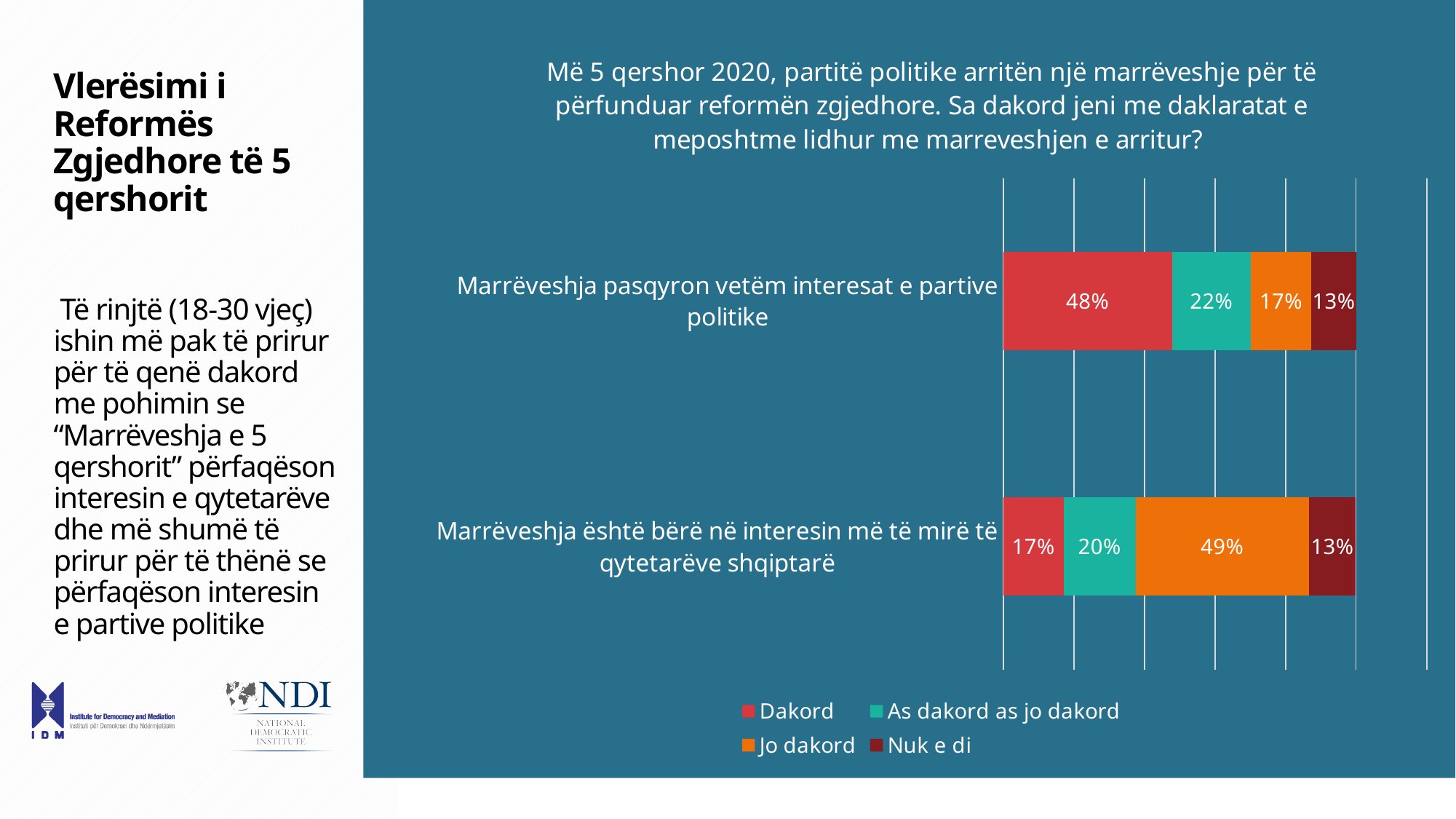
Which response category has the smallest share for the statement "Marrëveshja është bërë në interesin më të mirë të qytetarëve shqiptarë"? Nuk e di What is the "Nuk e di" value for the statement "Marrëveshja pasqyron vetëm interesat e partive politike"? 13% What percentage of respondents answered "Dakord" for the statement "Marrëveshja pasqyron vetëm interesat e partive politike"? 48% How many series does the legend list? 4 Which response category has the largest share for the statement "Marrëveshja pasqyron vetëm interesat e partive politike"? Dakord What type of chart is shown on the slide? Stacked bar chart What is the difference between the "Dakord" values for the two statements? 31 percentage points What percentage of respondents answered "Jo dakord" for the statement "Marrëveshja është bërë në interesin më të mirë të qytetarëve shqiptarë"? 49% How many statements (categories) are shown in the chart? 2 What is the "As dakord as jo dakord" value for the statement "Marrëveshja është bërë në interesin më të mirë të qytetarëve shqiptarë"? 20% Which statement has a higher "Jo dakord" share? Marrëveshja është bërë në interesin më të mirë të qytetarëve shqiptarë Which colour represents "Jo dakord" in the chart? Orange